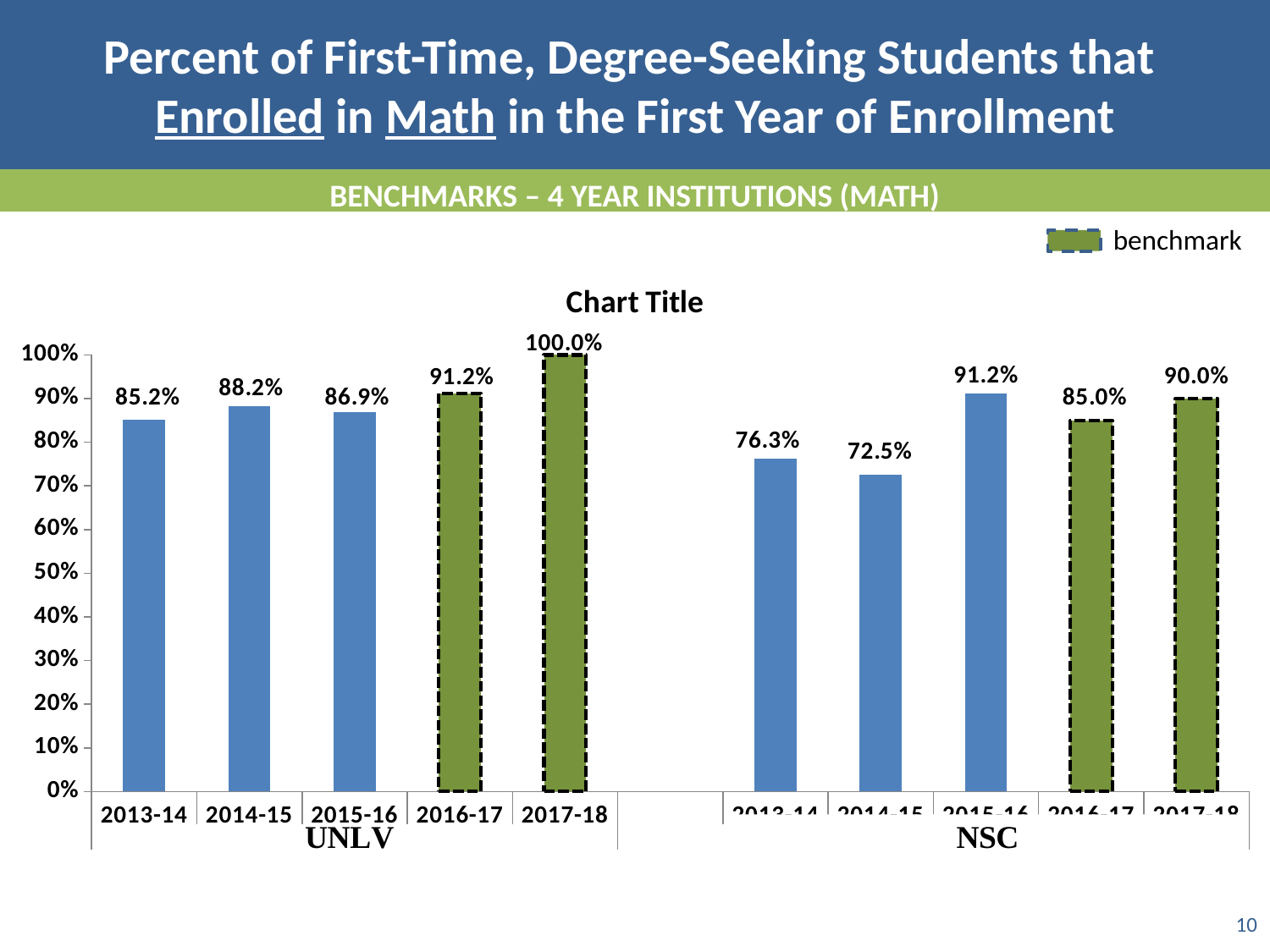
What is the value for UNLV in 2014-15? 88.2% Which is larger, the UNLV 2015-16 value or the NSC 2015-16 value? NSC 2015-16 What kind of chart is shown on the slide? Bar chart What is the value for NSC in 2014-15? 72.5% What is the difference between the UNLV 2014-15 value and the UNLV 2013-14 value? 3.0% Which year has the lowest value for NSC? 2014-15 What does the legend entry with the green dashed-outline bar represent? benchmark What is the difference between the NSC 2015-16 value and the NSC 2014-15 value? 18.7% Which year has the highest value for UNLV? 2017-18 What is the 2017-18 benchmark value for UNLV? 100.0% What is the 2016-17 benchmark value for NSC? 85.0% What is the value for UNLV in 2013-14? 85.2%